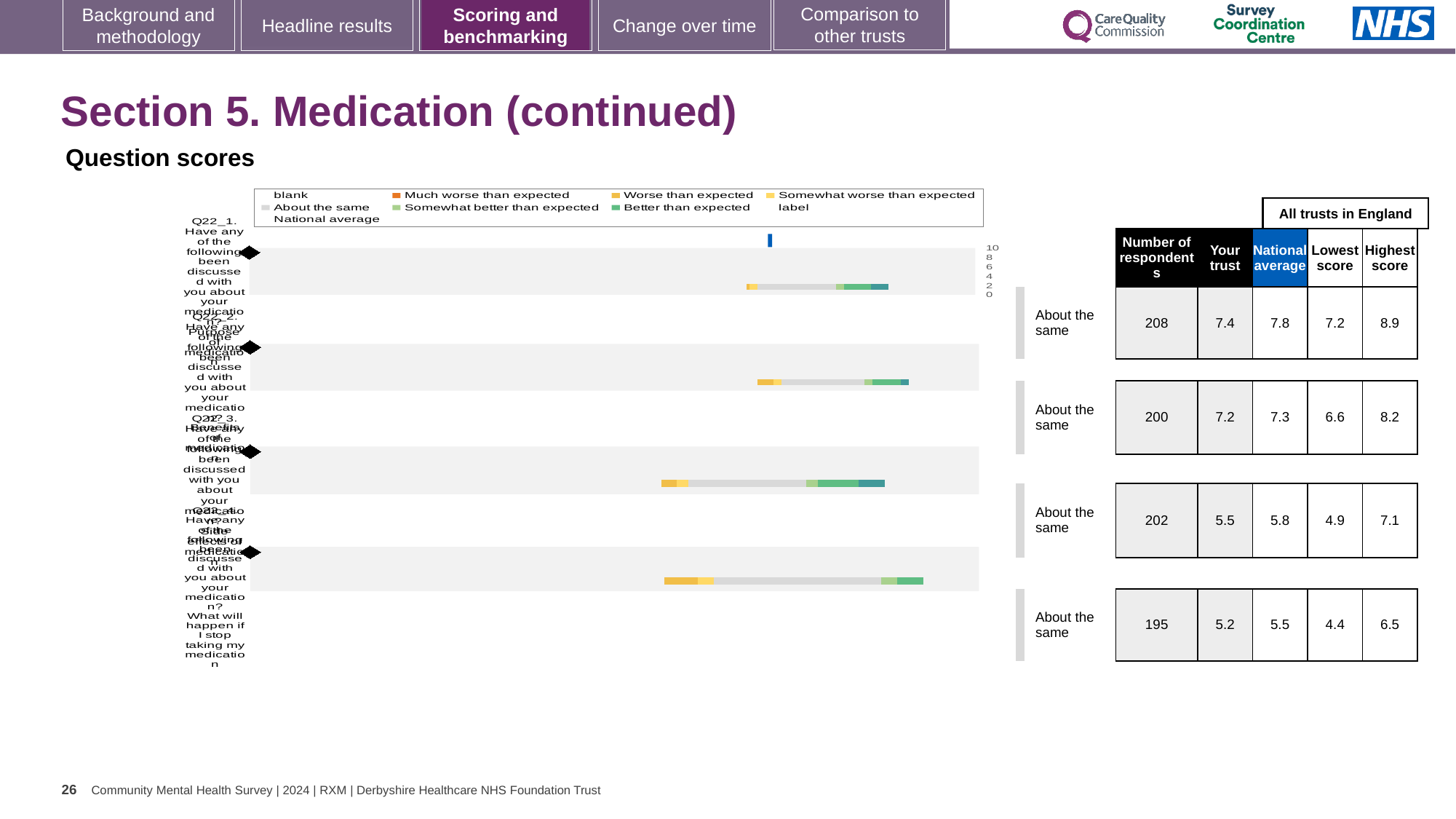
Which question in the chart has the highest 'Your trust' score? Q22_1 In the question scores chart, what is the highest score across all trusts in England for Q22_2? 8.2 For Q22_1, what is the difference between the national average and the 'Your trust' score? 0.4 How many questions (rows) are plotted in the question scores chart? 4 For Q22_3, which is larger: the 'Your trust' score or the national average? National average What kind of chart is used to show the question scores on this slide? bar chart In the question scores chart, what is the 'Your trust' score for Q22_1? 7.4 In the question scores chart, what is the national average for Q22_2? 7.3 Which question in the chart has the lowest 'Your trust' score? Q22_4 In the question scores chart, how many respondents answered Q22_4? 195 What benchmark category is shown for every question in the chart? About the same Is the 'Your trust' score for Q22_1 greater or less than 6? greater